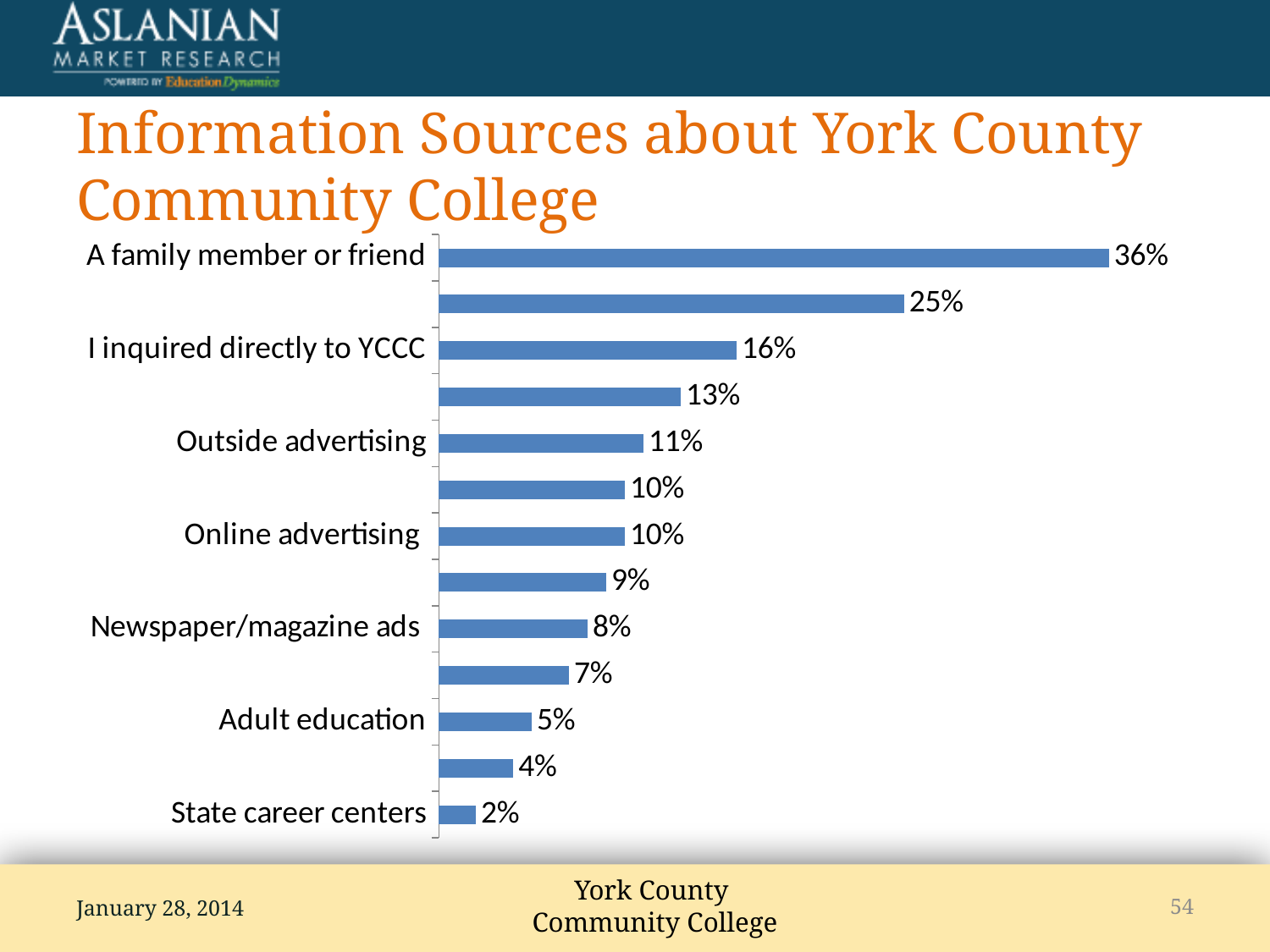
What is the difference between 'Outside advertising' and 'Adult education'? 6% Which is larger, 'Online advertising' or 'Newspaper/magazine ads'? Online advertising Which information source has the lowest value? State career centers What kind of chart is shown on the slide? Bar chart How many bars are plotted in the chart? 13 What is the value for 'Newspaper/magazine ads'? 8% What is the value for 'Outside advertising'? 11% What is the value for 'State career centers'? 2% What is the difference between 'A family member or friend' and 'I inquired directly to YCCC'? 20% What is the value for 'A family member or friend'? 36% Which information source has the highest value? A family member or friend What is the value for 'I inquired directly to YCCC'? 16%